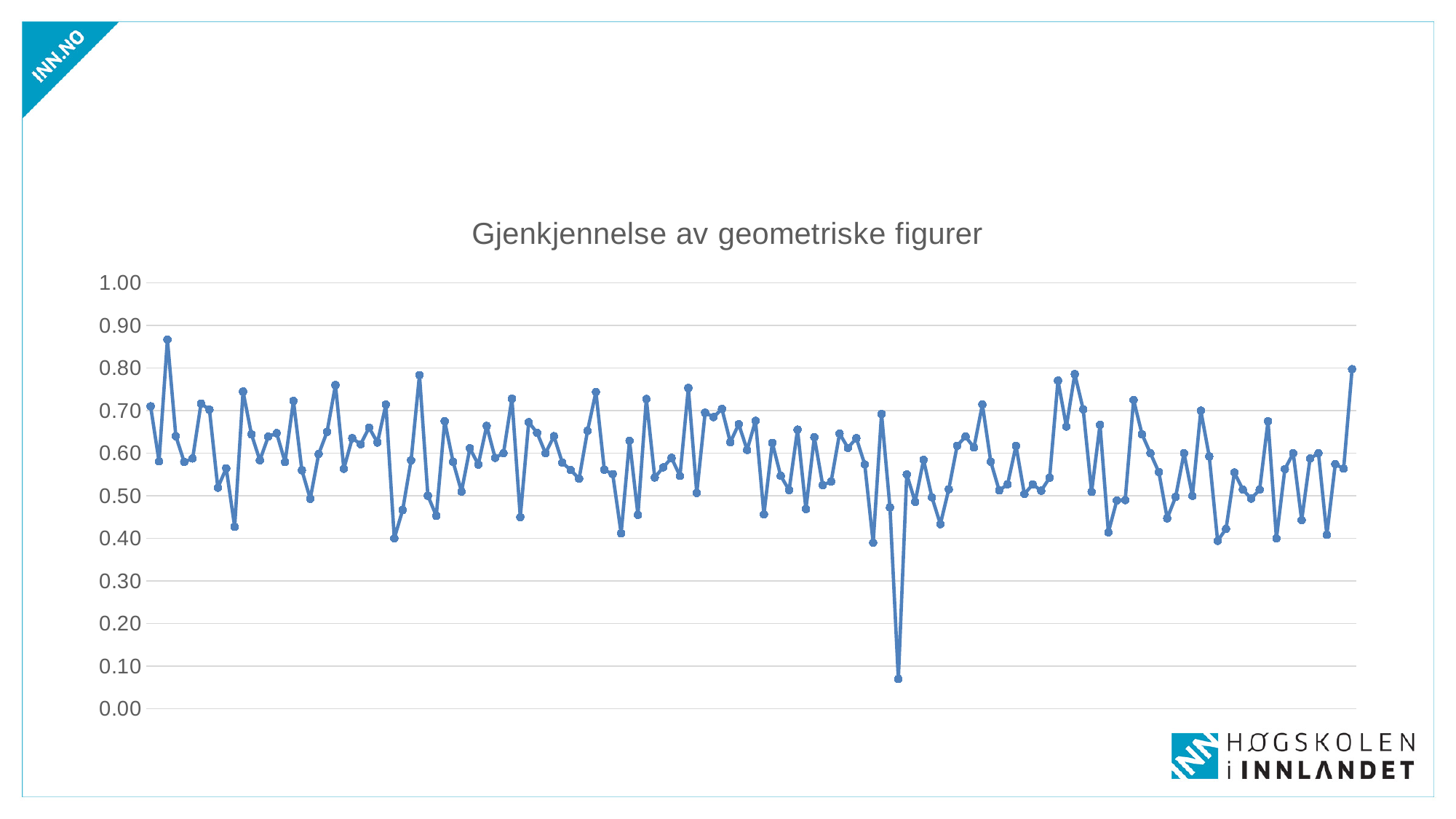
Is the highest point on the line greater or less than 0.80? greater Is the lowest point on the line greater or less than 0.10? less What is the highest value shown on the y axis? 1.00 What kind of chart is shown on the slide? line chart Is the first point on the line greater or less than 0.60? greater What is the title of the chart? Gjenkjennelse av geometriske figurer